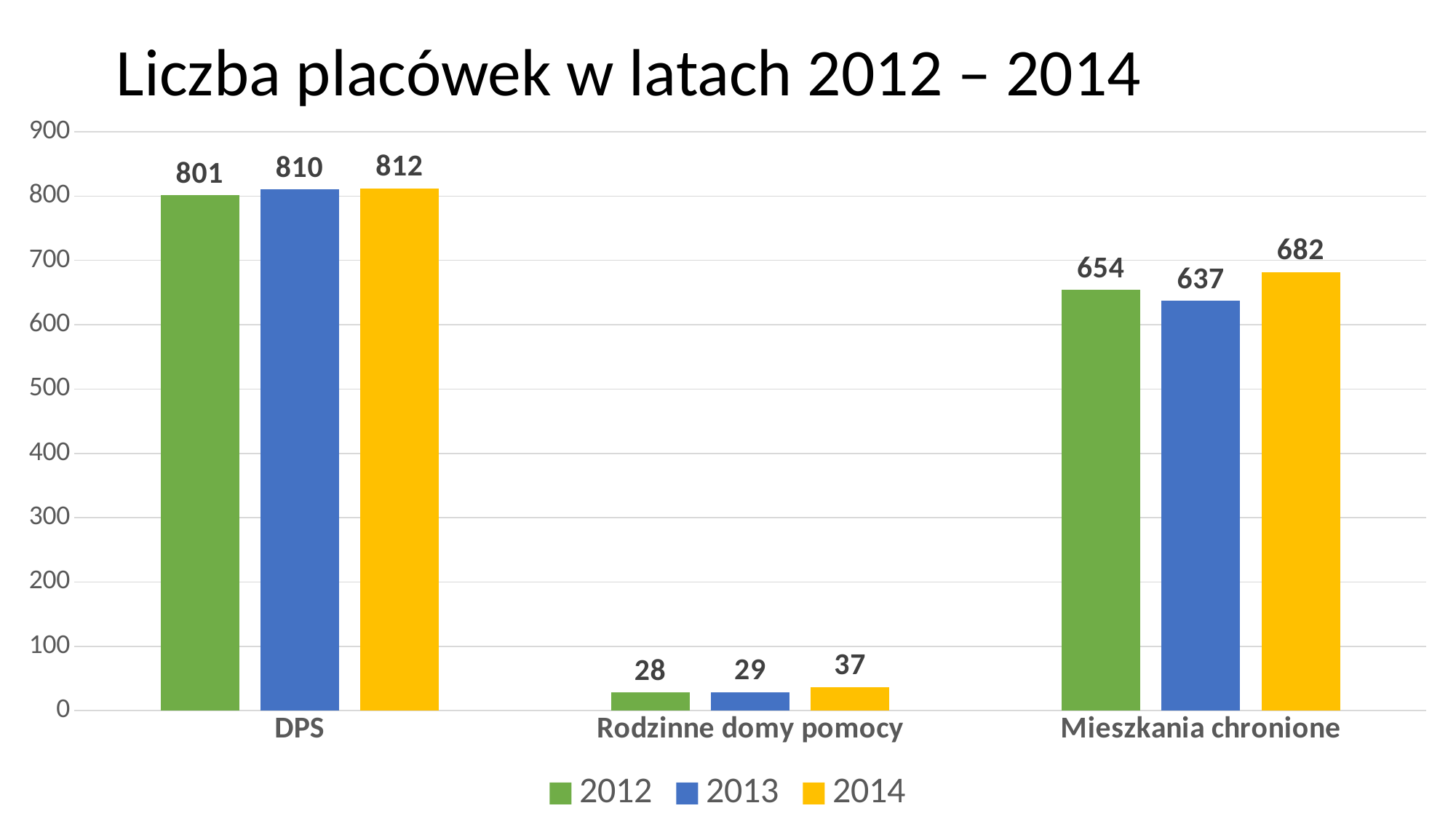
How many categories are shown on the x axis? 3 Which is larger for Mieszkania chronione: the 2012 value or the 2013 value? 2012 Which category has the highest value in 2014? DPS What is the difference between the 2014 and 2012 values for Mieszkania chronione? 28 What is the value for Rodzinne domy pomocy in 2014? 37 How many series does the legend list? 3 Which category has the lowest value in 2013? Rodzinne domy pomocy Is the value for Mieszkania chronione in 2014 greater or less than 700? less What is the difference between the 2013 and 2012 values for DPS? 9 What kind of chart is shown on the slide? bar chart What is the value for Mieszkania chronione in 2013? 637 What is the value for DPS in 2012? 801